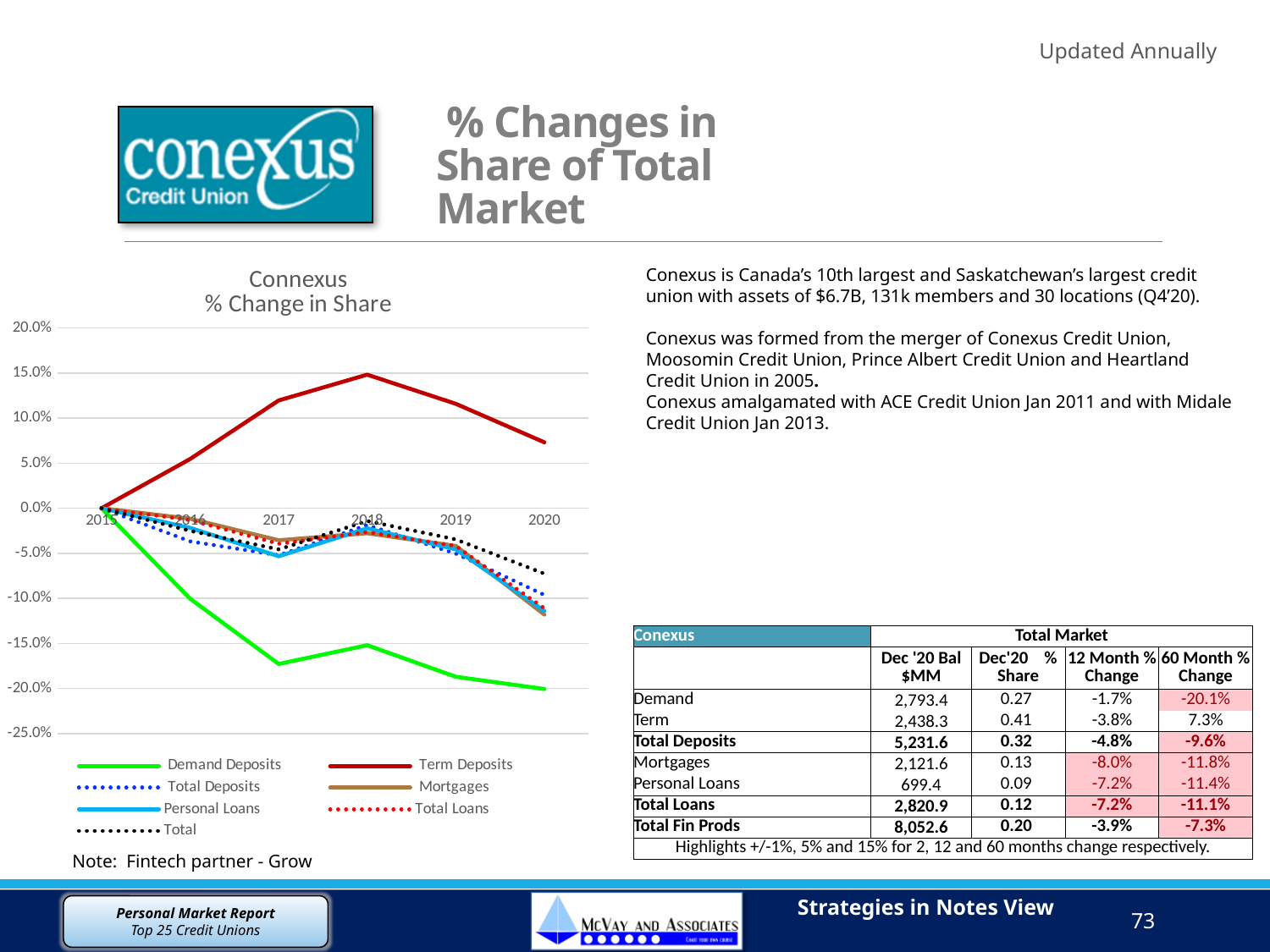
In the "Connexus % Change in Share" chart, which series has the lowest value in 2020? Demand Deposits In the "Connexus % Change in Share" chart, which is larger in 2019: Term Deposits or Demand Deposits? Term Deposits In the "Connexus % Change in Share" chart, does the Term Deposits line rise or fall from 2015 to 2018? rise How many years are shown on the x axis of the "Connexus % Change in Share" chart? 6 In the "Connexus % Change in Share" chart, which series has the highest value in 2020? Term Deposits In the "Connexus % Change in Share" chart, is the value for Demand Deposits in 2020 greater or less than -15.0%? less How many series does the legend of the "Connexus % Change in Share" chart list? 7 What kind of chart is the "Connexus % Change in Share" chart? line chart What colour is the Demand Deposits line in the "Connexus % Change in Share" chart? green In the "Connexus % Change in Share" chart, is the value for Term Deposits in 2020 greater or less than 5.0%? greater In the "Connexus % Change in Share" chart, does the Demand Deposits line rise or fall from 2015 to 2017? fall In the "Connexus % Change in Share" chart, is the value for Term Deposits in 2017 greater or less than 10.0%? greater